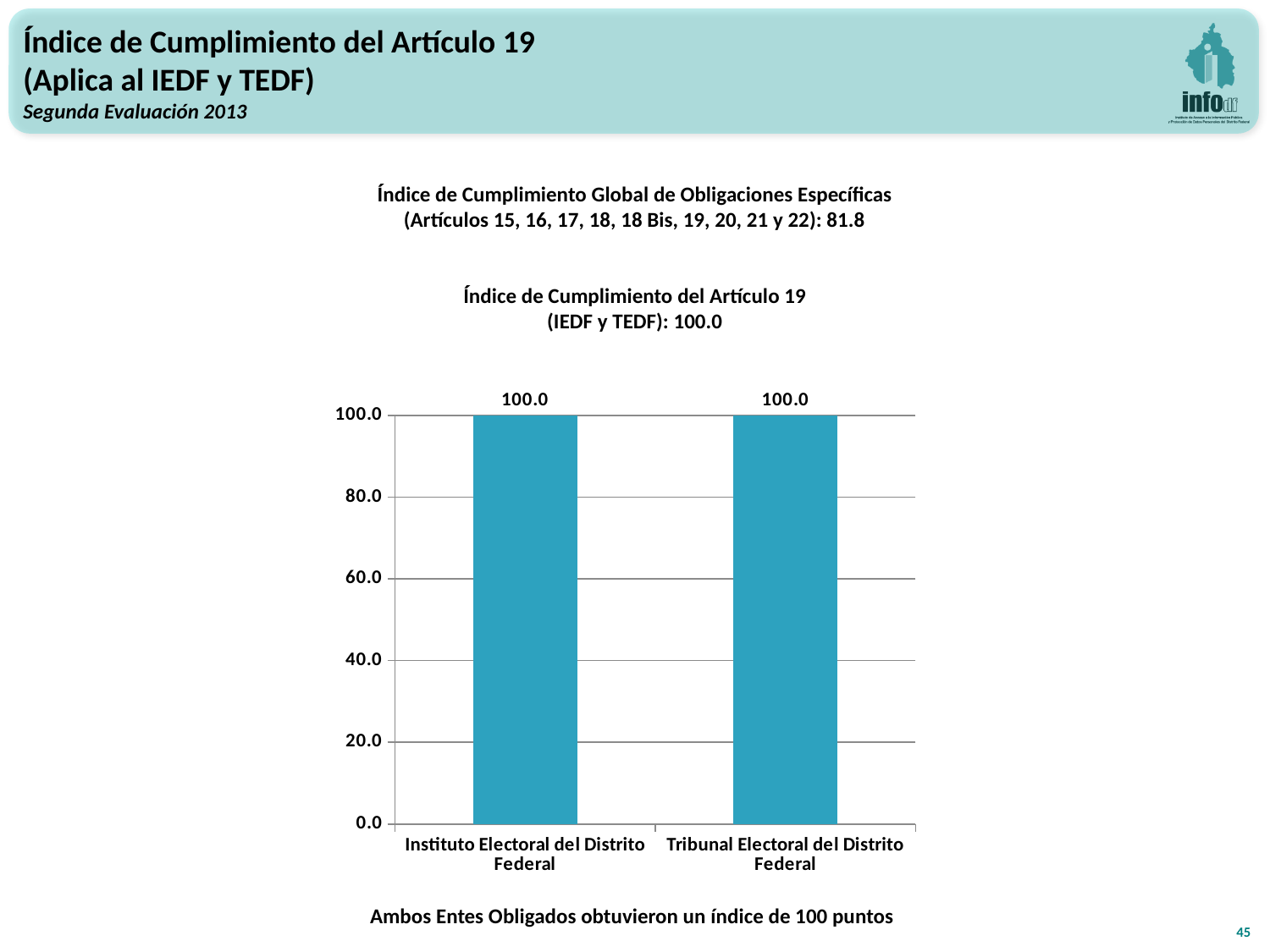
Is the value for Instituto Electoral del Distrito Federal greater or less than 60.0? greater What colour are the bars in the chart? blue What is the value for Tribunal Electoral del Distrito Federal? 100.0 Is the value for Tribunal Electoral del Distrito Federal greater or less than 80.0? greater What kind of chart is shown on the slide? bar chart Do the values rise, fall or stay the same from the first bar to the second bar? stay the same How many categories are shown on the x axis of the chart? 2 What is the value for Instituto Electoral del Distrito Federal? 100.0 What is the difference between the values for Instituto Electoral del Distrito Federal and Tribunal Electoral del Distrito Federal? 0.0 What is the highest value shown on the y axis of the chart? 100.0